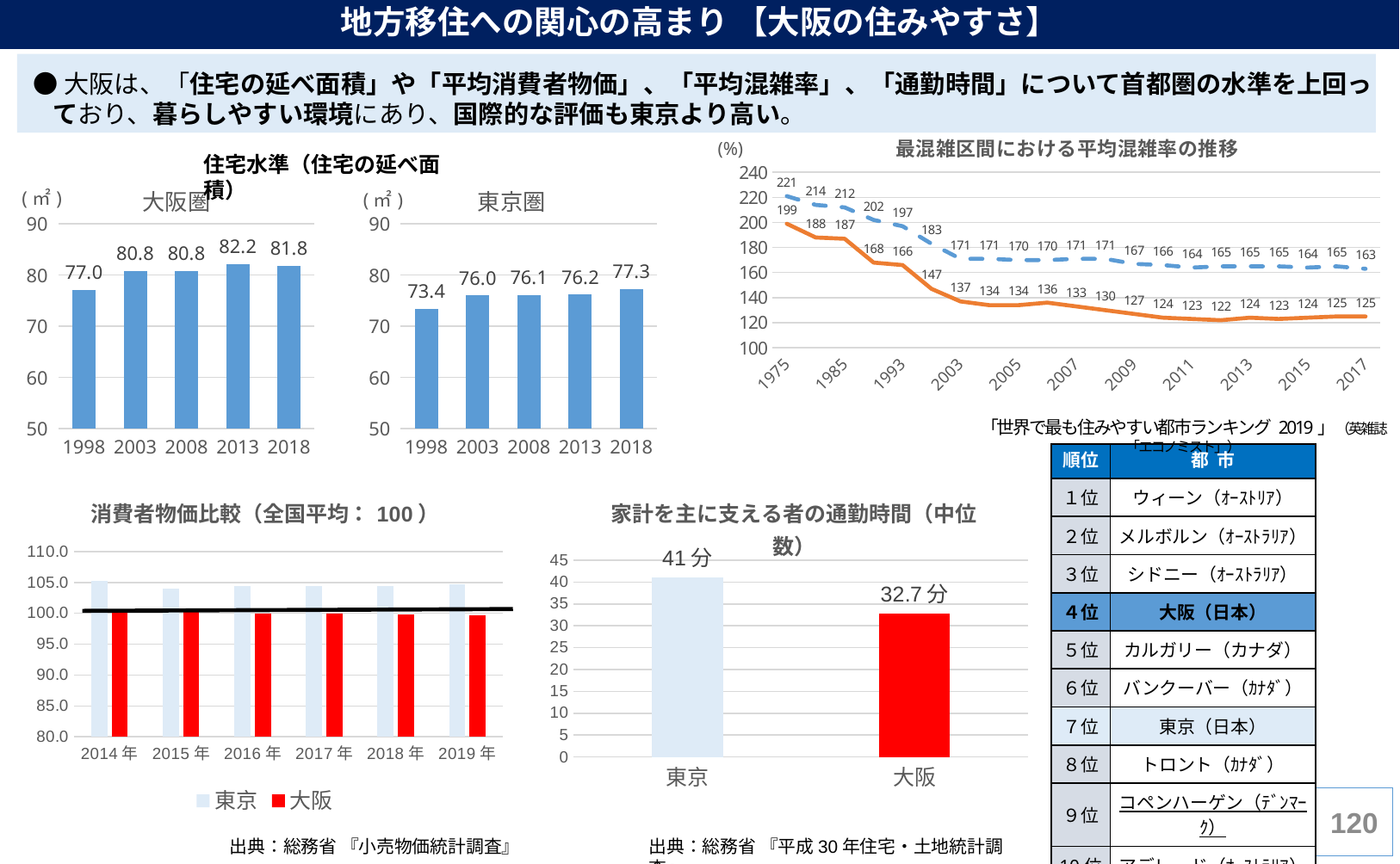
In the 家計を主に支える者の通勤時間 chart, what is the difference between 東京 and 大阪? 8.3分 How many series does the legend of the 消費者物価比較 chart list? 2 In the 家計を主に支える者の通勤時間 chart, what is the value for 東京? 41分 In the 住宅水準 chart for 大阪圏, what is the value for 2013? 82.2 In the 家計を主に支える者の通勤時間 chart, which is larger, 東京 or 大阪? 東京 In the 住宅水準 charts, what is the difference between the 2018 value for 大阪圏 and the 2018 value for 東京圏? 4.5 In the 最混雑区間における平均混雑率の推移 chart, does the solid orange line rise or fall from 1975 to 2017? fall In the 住宅水準 chart for 大阪圏, which year has the highest value? 2013 In the 住宅水準 chart for 東京圏, what is the value for 1998? 73.4 In the 消費者物価比較 chart, is the value for 東京 in 2014年 greater or less than 100.0? greater How many bars are in the 住宅水準 chart for 大阪圏? 5 In the 住宅水準 chart for 東京圏, which year has the lowest value? 1998